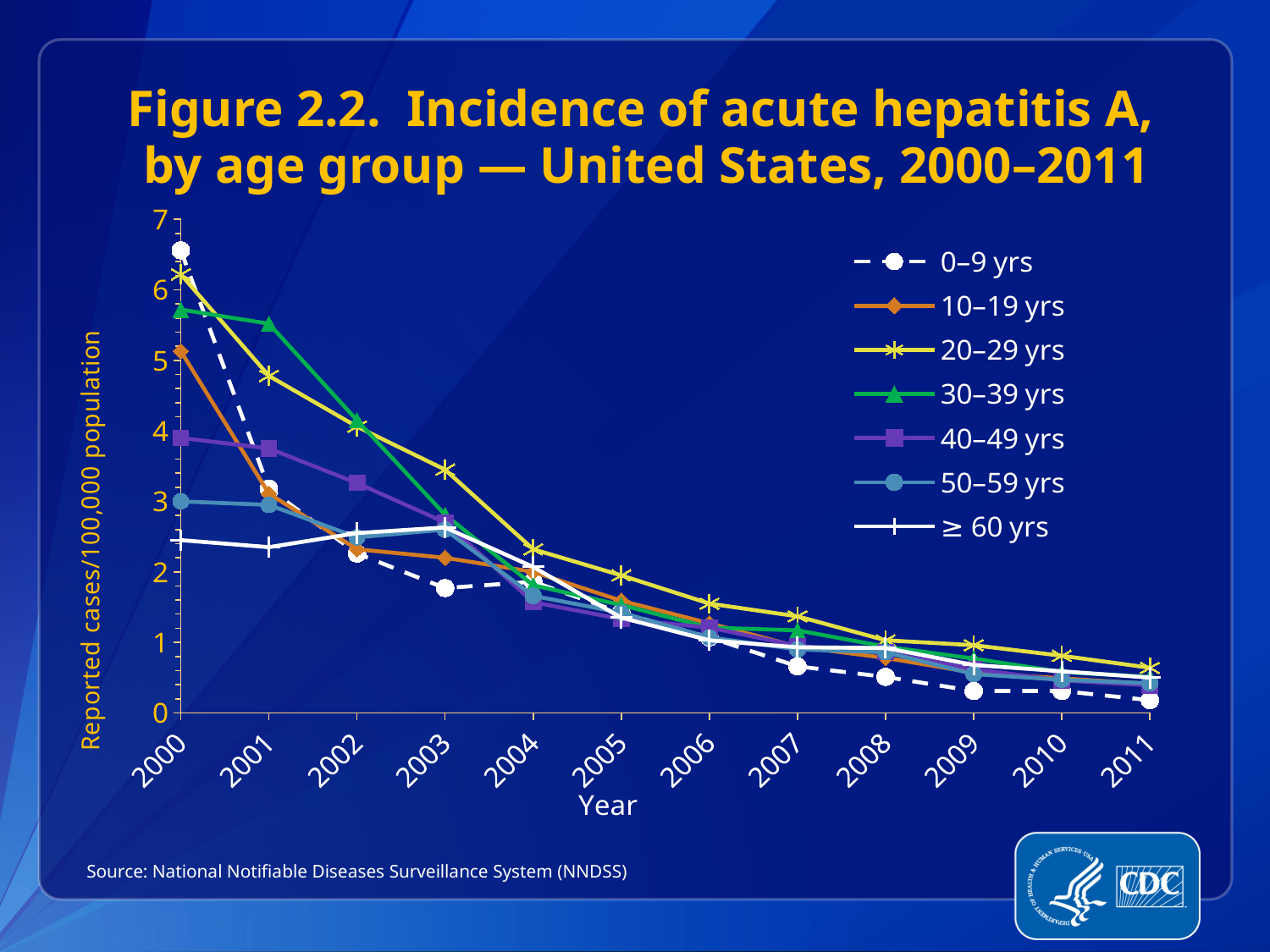
Which age group has the lowest incidence in 2011? 0–9 yrs How many years are shown along the x axis? 12 What is the label of the y axis? Reported cases/100,000 population Is the value for ≥ 60 yrs in 2000 greater or less than 3? less Which age group has the highest incidence in 2005? 20–29 yrs Do the values for the 20–29 yrs series rise or fall from 2000 to 2011? fall How many age-group series does the legend list? 7 Is the value for 0–9 yrs in 2000 greater or less than 6? greater In 2001, which is larger: the value for 30–39 yrs or the value for 40–49 yrs? 30–39 yrs Is the value for 30–39 yrs in 2002 greater or less than 3? greater What kind of chart is shown on the slide? line chart